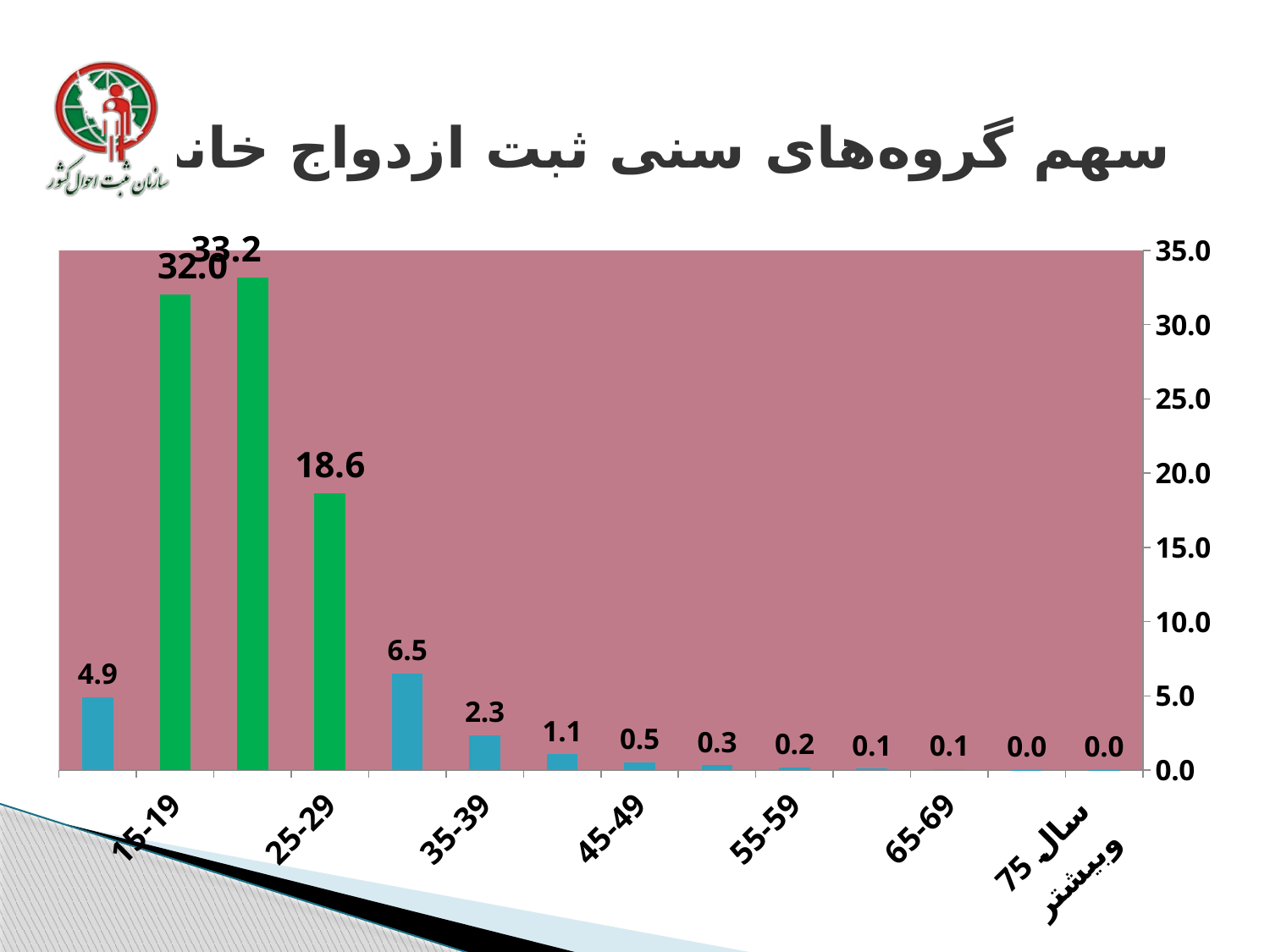
What is the value for the 15-19 age group? 32.0 Is the value for the 15-19 age group greater or less than 30.0? greater How many bars are plotted on the chart? 14 Which has a larger value, the 25-29 age group or the 35-39 age group? 25-29 What is the value for the 35-39 age group? 2.3 What is the value for the 75 سال و بیشتر age group? 0.0 What is the highest value shown on the chart? 33.2 What type of chart is shown on the slide? bar chart What is the value for the 45-49 age group? 0.5 What is the difference between the values for the 15-19 and 25-29 age groups? 13.4 What is the value for the 55-59 age group? 0.2 What is the value for the 25-29 age group? 18.6